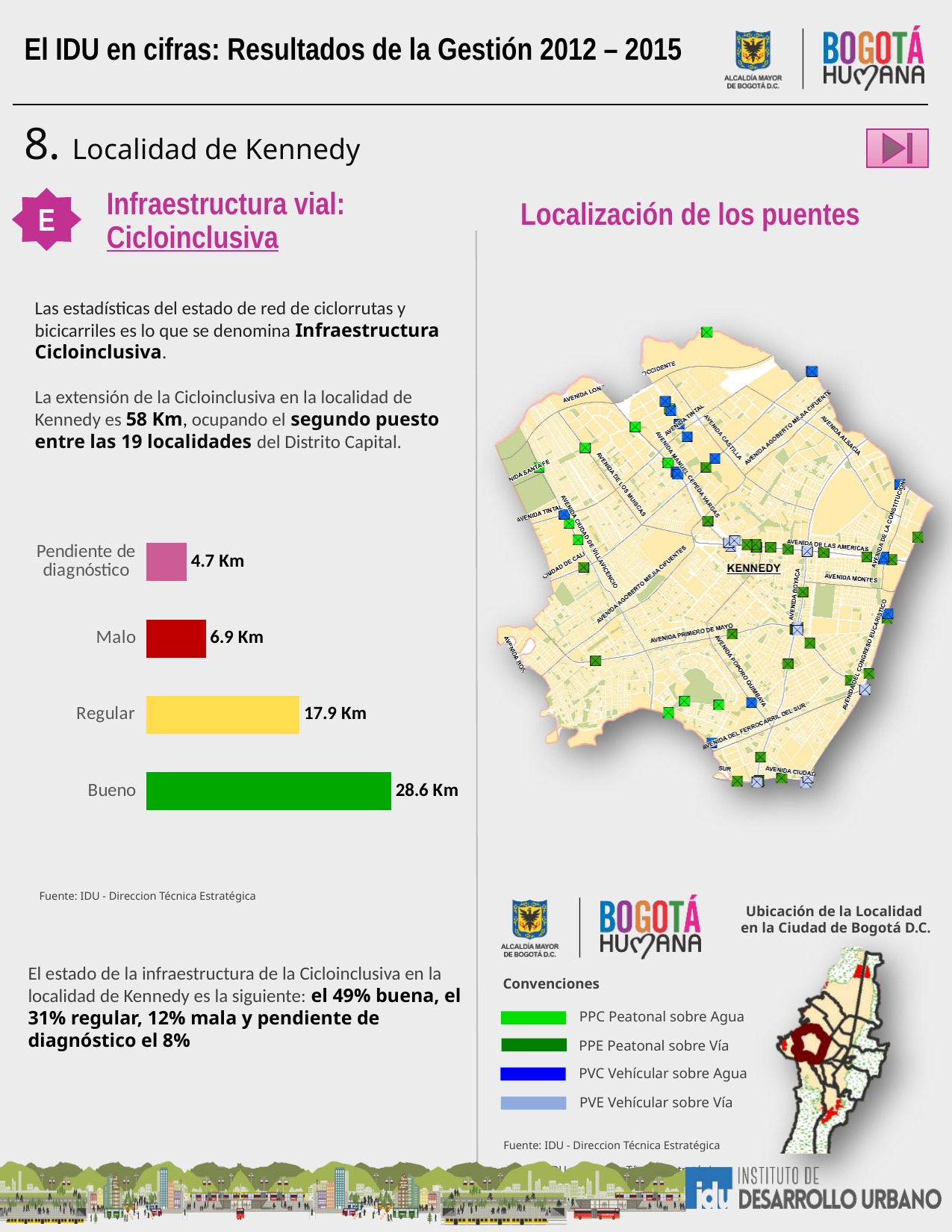
Which is larger, the value for Regular or the value for Malo? Regular What is the difference between the values for Bueno and Regular? 10.7 Km What is the value for Regular in the bar chart? 17.9 Km What colour is the bar for Malo? Red What is the value for Malo in the bar chart? 6.9 Km What is the difference between the values for Malo and Pendiente de diagnóstico? 2.2 Km What is the value for Bueno in the bar chart? 28.6 Km What is the value for Pendiente de diagnóstico in the bar chart? 4.7 Km Which category has the lowest value in the bar chart? Pendiente de diagnóstico What kind of chart is shown on the left of the slide? Bar chart How many categories are shown in the bar chart? 4 Which category has the highest value in the bar chart? Bueno